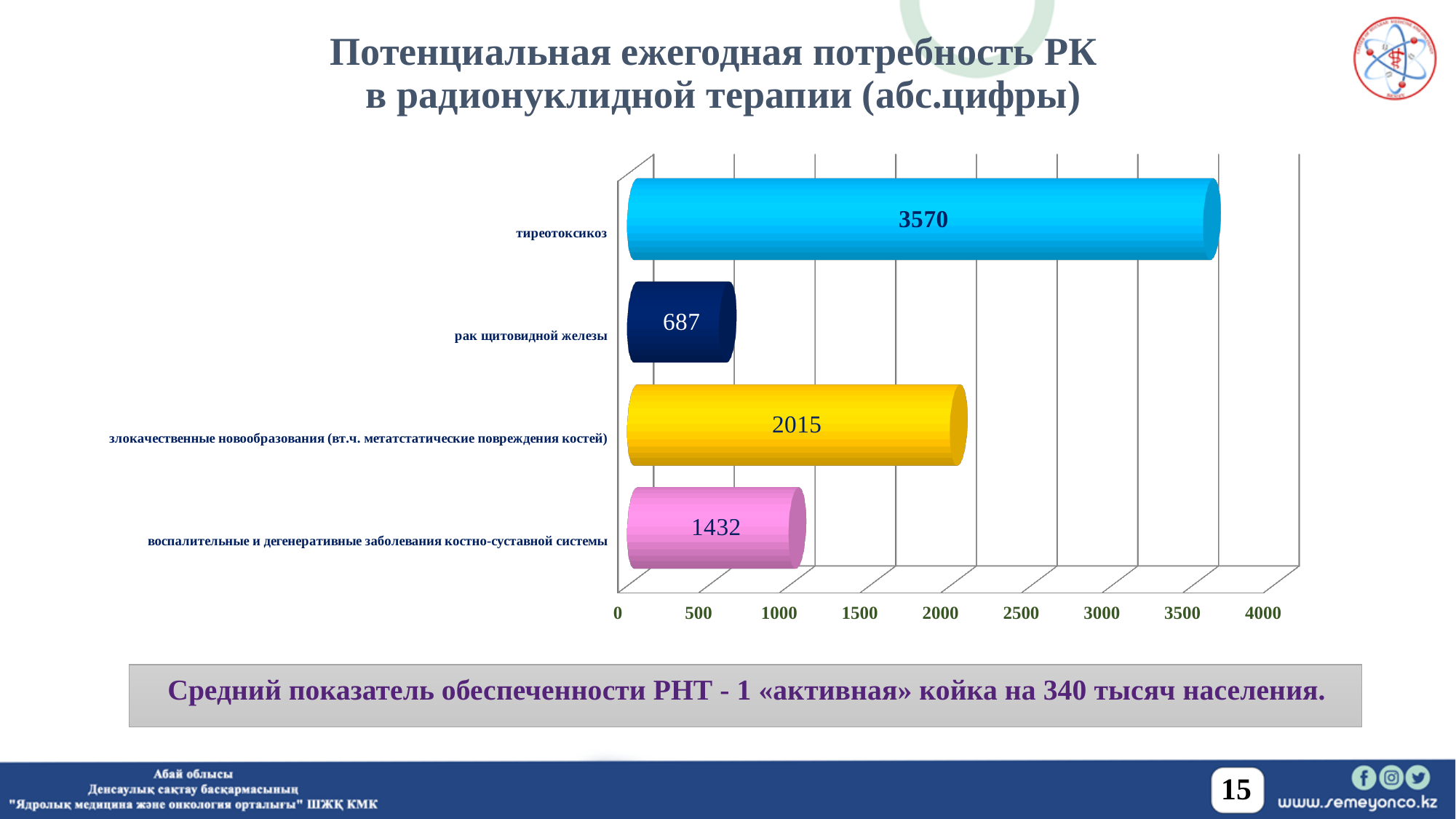
What is the value for рак щитовидной железы? 687 What is the difference between the values for тиреотоксикоз and рак щитовидной железы? 2883 What is the difference between the values for злокачественные новообразования and воспалительные и дегенеративные заболевания костно-суставной системы? 583 How many categories are shown in the chart? 4 What is the value for воспалительные и дегенеративные заболевания костно-суставной системы? 1432 Which is larger: the value for злокачественные новообразования or the value for воспалительные и дегенеративные заболевания костно-суставной системы? злокачественные новообразования Which category has the lowest value? рак щитовидной железы Which category has the highest value? тиреотоксикоз What is the value for злокачественные новообразования (вт.ч. метатстатические повреждения костей)? 2015 Is the value for тиреотоксикоз greater or less than 3000? greater What kind of chart is shown on the slide? bar chart What is the value for тиреотоксикоз? 3570